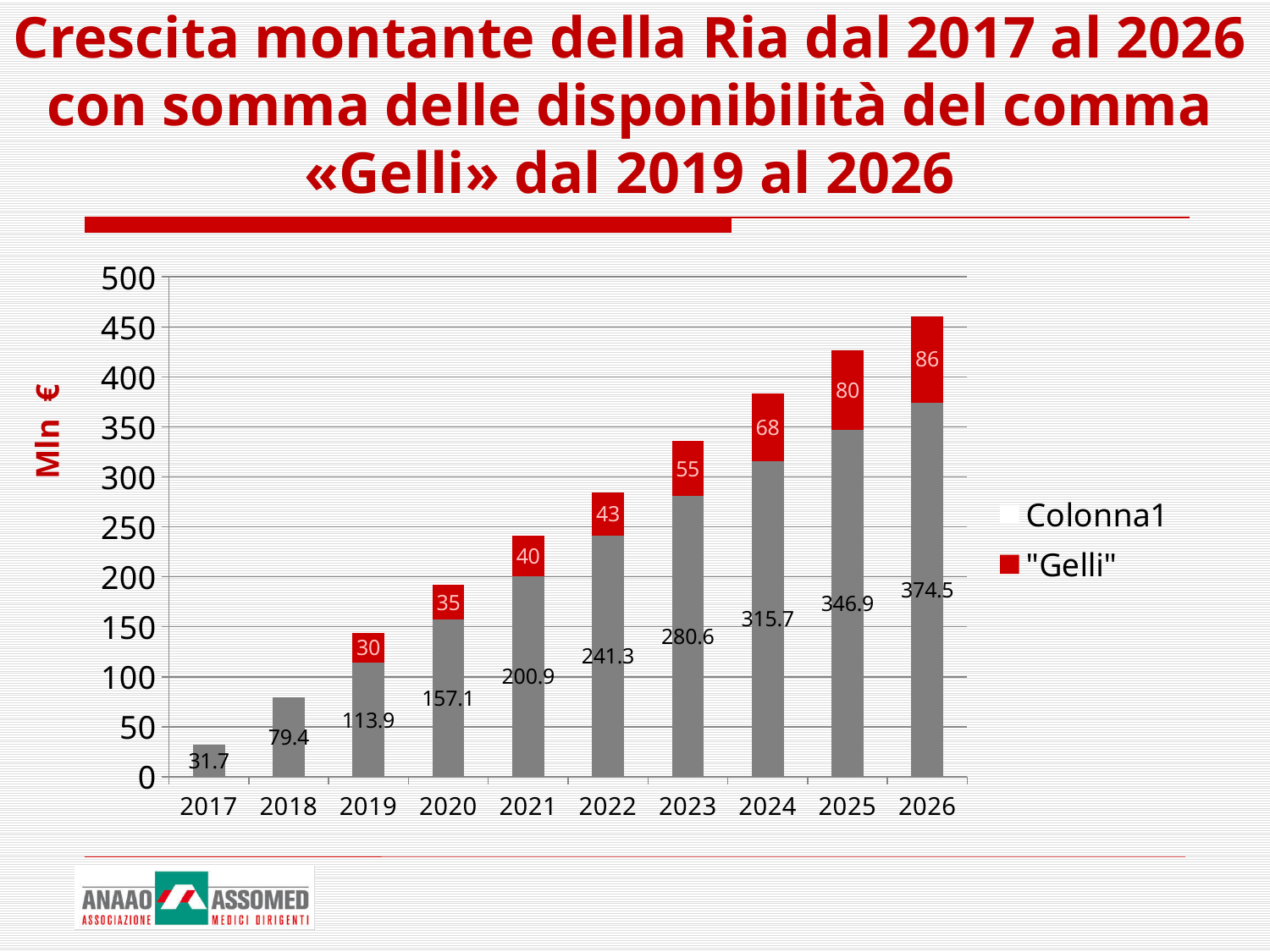
Do the grey segment values rise or fall from 2017 to 2026? Rise What is the value of the grey segment for 2024? 315.7 What is the value of the "Gelli" segment for 2022? 43 What is the total of the stacked bar for 2026? 460.5 What type of chart is shown on the slide? Stacked bar chart How many series does the chart legend list? 2 In which year is the grey segment the smallest? 2017 What is the difference between the grey segment values for 2026 and 2017? 342.8 In which year is the "Gelli" segment the largest? 2026 How many years are shown on the x axis of the chart? 10 What unit is shown on the y axis label of the chart? Mln € What is the value of the grey segment for 2017? 31.7